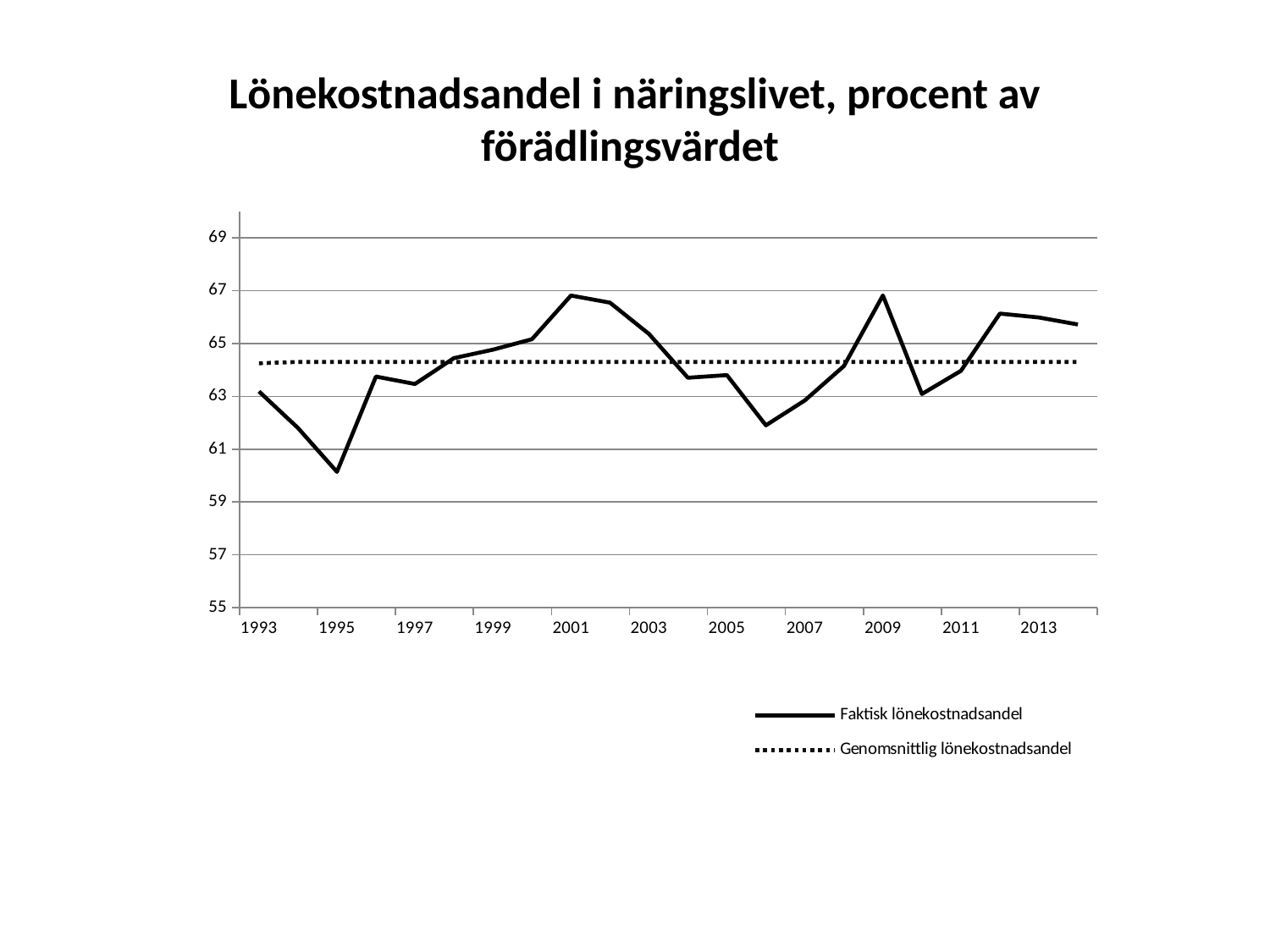
Is the value of Faktisk lönekostnadsandel in 2006 greater or less than 63? less What kind of chart is shown on the slide? Line chart What is the title of the chart? Lönekostnadsandel i näringslivet, procent av förädlingsvärdet Which year has the higher Faktisk lönekostnadsandel, 1995 or 2006? 2006 Is the value of Faktisk lönekostnadsandel in 2001 greater or less than 65? greater How many series does the legend list? 2 Is the value of Faktisk lönekostnadsandel in 1995 greater or less than 61? less Which series is drawn with a dotted line? Genomsnittlig lönekostnadsandel Does the Faktisk lönekostnadsandel rise or fall from 1993 to 1995? Fall In which year is the Faktisk lönekostnadsandel at its lowest? 1995